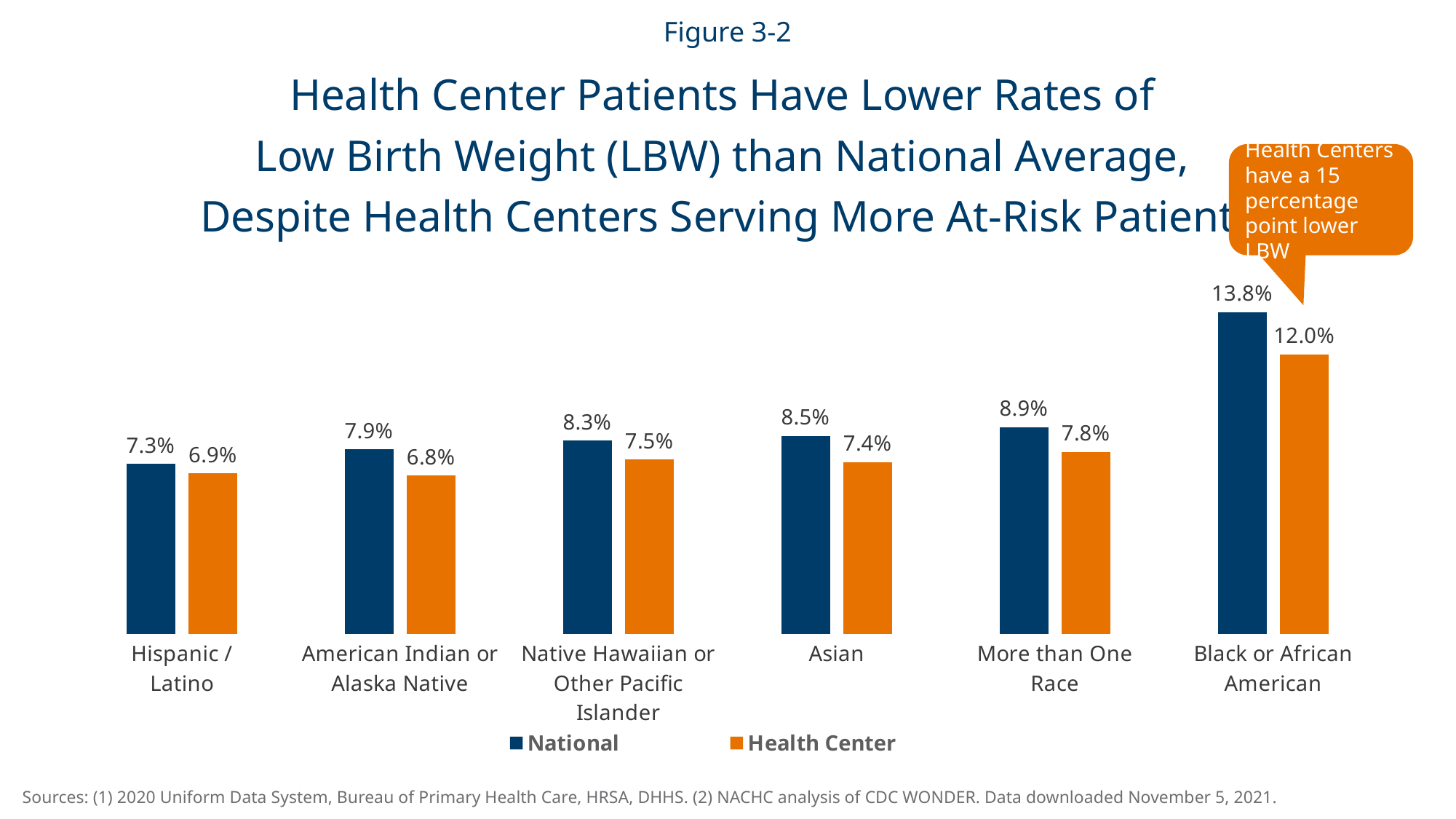
Which is larger, the National rate for Asian patients or the Health Center rate for Black or African American patients? Health Center rate for Black or African American patients Which colour represents the Health Center series? Orange What is the Health Center value for American Indian or Alaska Native? 6.8% How many series does the legend list? 2 Which category has the highest National low birth weight rate? Black or African American What is the difference between the National and Health Center rates for More than One Race? 1.1% Which category has the lowest Health Center low birth weight rate? American Indian or Alaska Native How many race/ethnicity categories are shown on the chart? 6 What is the difference between the National and Health Center rates for Black or African American patients? 1.8% What kind of chart is shown on the slide? Bar chart What is the Health Center low birth weight rate for Asian patients? 7.4% What is the National low birth weight rate for Black or African American patients? 13.8%